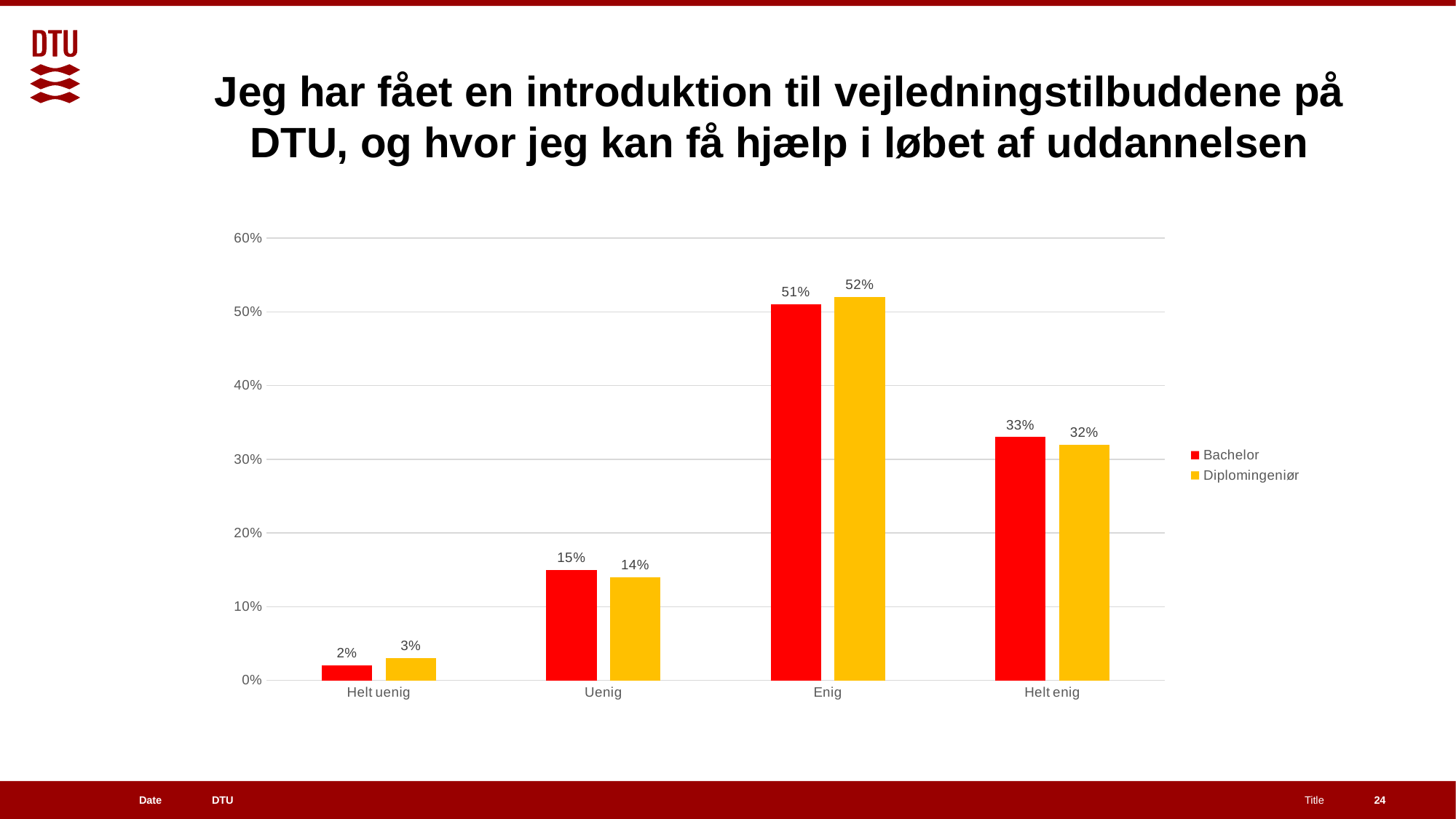
Which is larger for Uenig: the Bachelor value or the Diplomingeniør value? Bachelor What is the difference between the Bachelor and Diplomingeniør values for Enig? 1% How many series does the legend list? 2 Which category has the lowest Diplomingeniør value? Helt uenig What is the Diplomingeniør value for Uenig? 14% What is the difference between the Bachelor values for Enig and Helt enig? 18% What is the Diplomingeniør value for Helt uenig? 3% What is the Bachelor value for Helt enig? 33% How many categories are shown on the x axis? 4 Which category has the highest Bachelor value? Enig What kind of chart is shown on the slide? Bar chart What is the Bachelor value for Enig? 51%